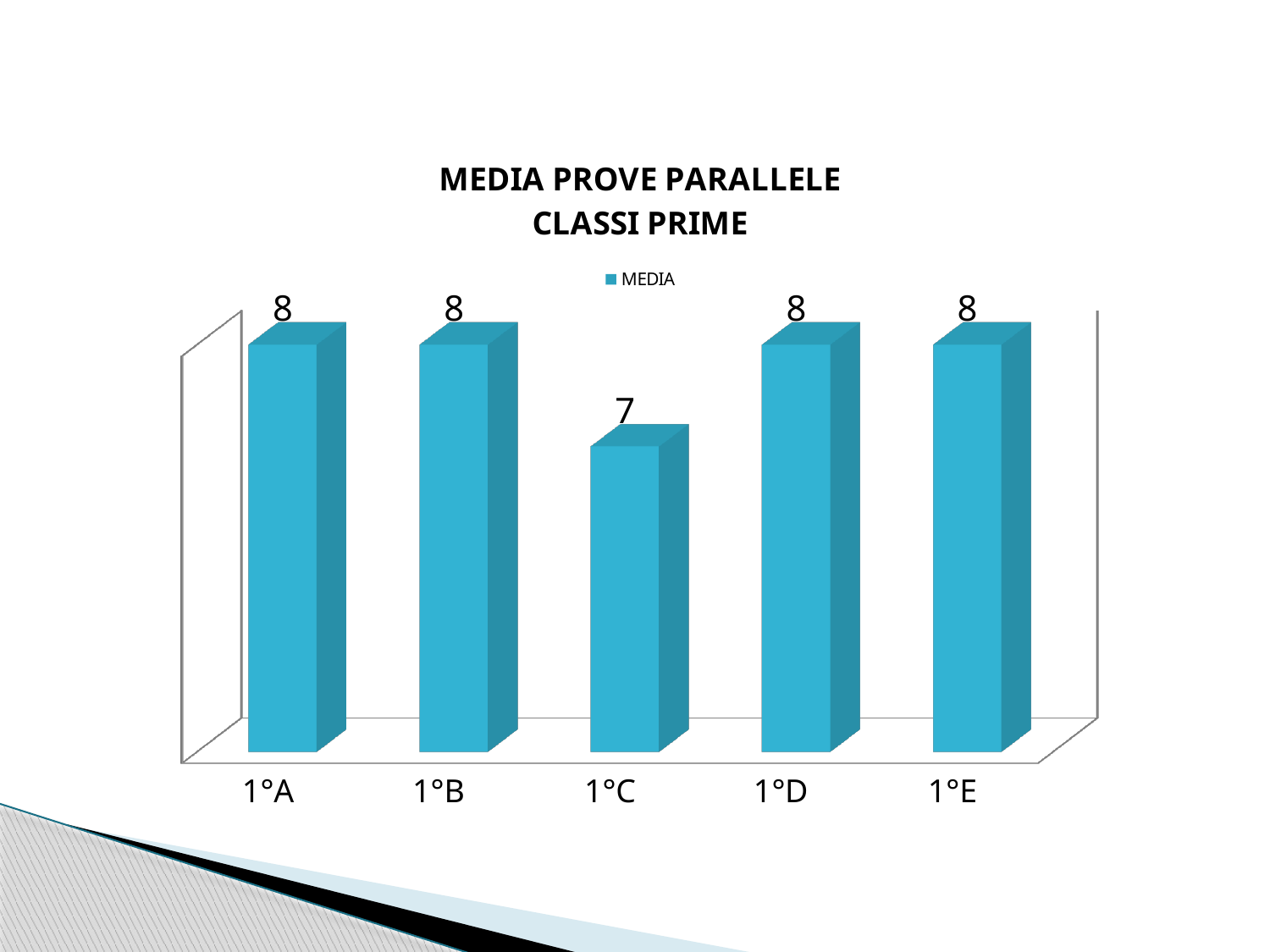
What is the name of the series in the legend? MEDIA What is the difference between the values for 1°B and 1°C? 1 How many classes are shown on the x axis? 5 What is the value for 1°E? 8 What is the value for 1°A? 8 What kind of chart is this? bar chart Which class has the lowest value? 1°C What is the value for 1°C? 7 What is the title of the chart? MEDIA PROVE PARALLELE CLASSI PRIME How many classes have a value of 8? 4 How many series does the legend list? 1 Which is larger, the value for 1°D or the value for 1°C? 1°D